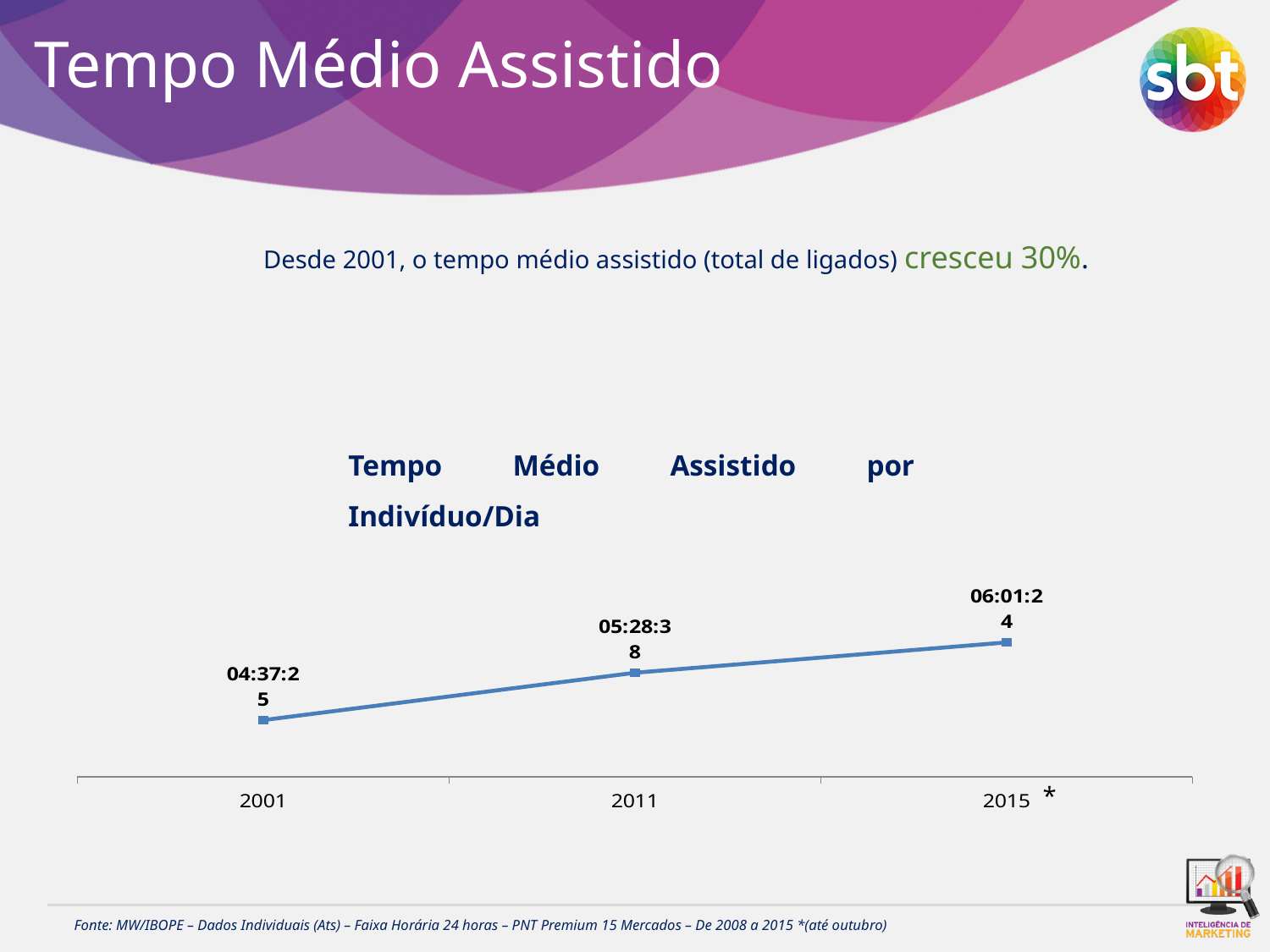
Which year on the x axis is marked with an asterisk? 2015 What is the value for 2015 in the chart? 06:01:24 Which is larger, the value for 2001 or the value for 2011? 2011 What is the title of the chart? Tempo Médio Assistido por Indivíduo/Dia Which is larger, the value for 2011 or the value for 2015? 2015 Which year has the highest value in the chart? 2015 What is the value for 2001 in the chart? 04:37:25 Do the values rise or fall from 2001 to 2015? rise What is the value for 2011 in the chart? 05:28:38 What kind of chart is shown on the slide? line chart Which year has the lowest value in the chart? 2001 How many data points are plotted in the chart? 3